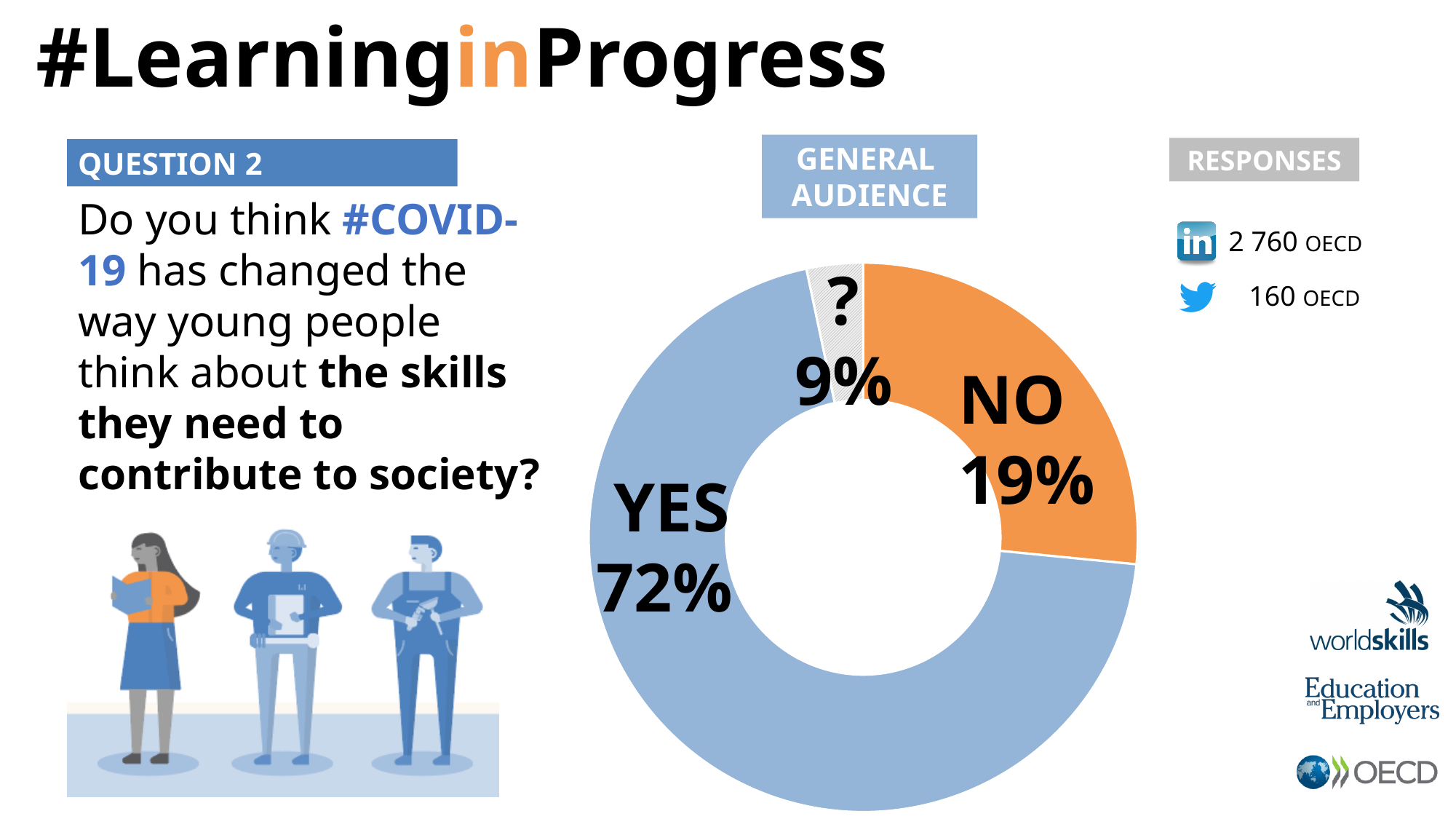
Which is larger, the YES share or the NO share? YES What is the difference in percentage points between the YES and NO shares? 53 percentage points Which audience does the chart represent, according to the label above it? General audience What colour is the NO slice of the chart? Orange How many slices does the chart have? 3 What is the difference in percentage points between the NO share and the '?' share? 10 percentage points What share of the general audience is shown for the '?' (undecided) slice? 9% What kind of chart is shown on the slide? Pie (doughnut) chart Which response received the smallest share of the general audience? ? Which response received the largest share of the general audience? YES What share of the general audience answered NO? 19% What share of the general audience answered YES? 72%